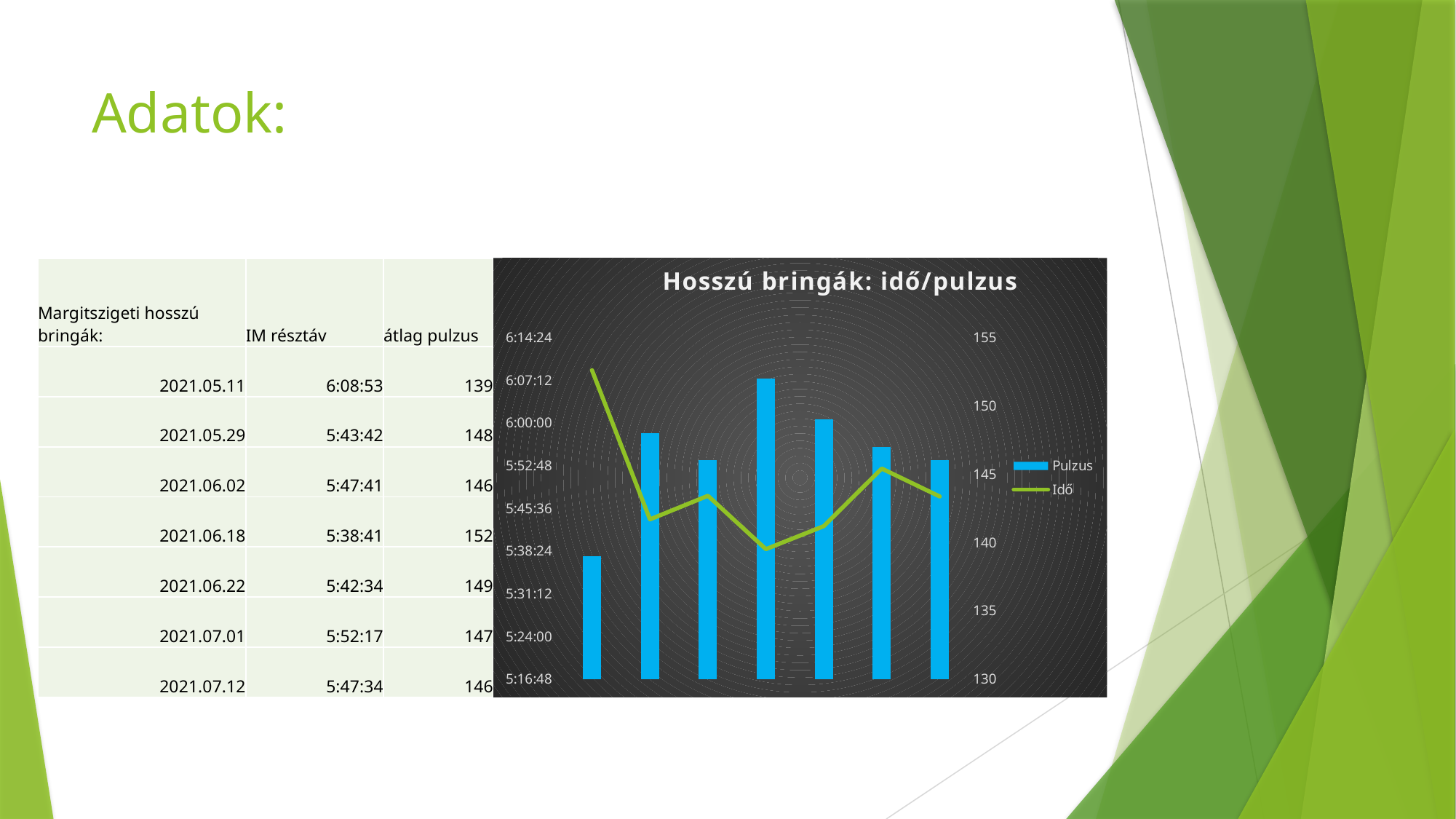
Which is larger, the first Pulzus bar or the fourth Pulzus bar? The fourth bar What kind of chart is shown on the slide? Combined bar and line chart What is the title of the chart? Hosszú bringák: idő/pulzus Which bar in the Pulzus series is the shortest, counting from the left? The first bar How many series does the chart legend list? 2 Is the value of the fourth Pulzus bar greater or less than 150? greater Does the Idő line rise or fall between its first and second points? fall Which bar in the Pulzus series is the tallest, counting from the left? The fourth bar How many bars are plotted in the chart? 7 Is the first point of the Idő line greater or less than 6:00:00? greater Is the value of the second Pulzus bar greater or less than 145? greater Which series is drawn as a green line in the chart? Idő